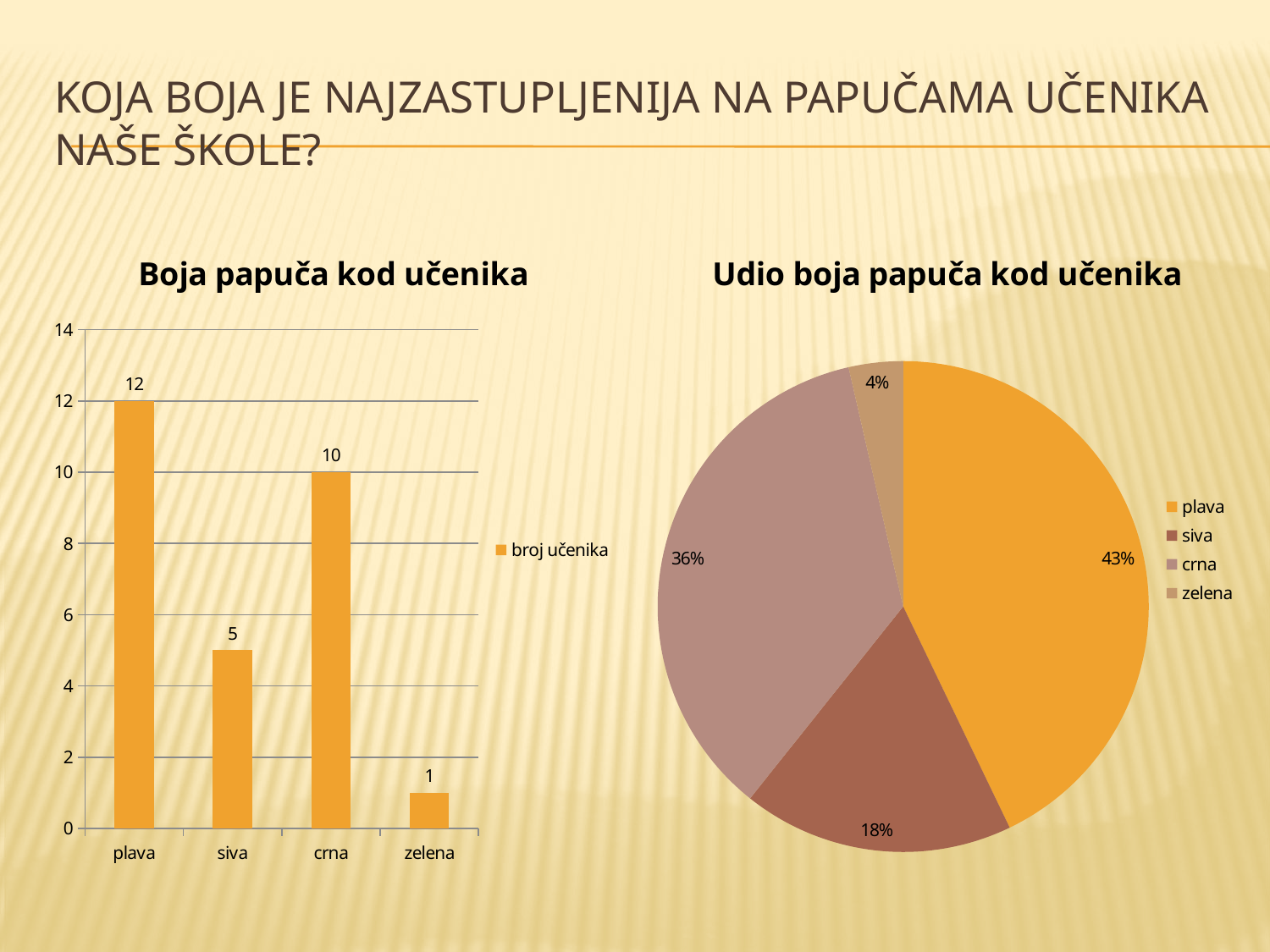
What kind of chart is the chart titled 'Boja papuča kod učenika'? bar chart In the chart titled 'Boja papuča kod učenika', what is the value for plava? 12 In the chart titled 'Boja papuča kod učenika', which is larger, the value for siva or the value for crna? crna In the chart titled 'Boja papuča kod učenika', how many categories are shown on the x axis? 4 In the chart titled 'Udio boja papuča kod učenika', what share does crna have? 36% What kind of chart is the chart titled 'Udio boja papuča kod učenika'? pie chart In the chart titled 'Boja papuča kod učenika', what is the difference between the values for plava and crna? 2 In the chart titled 'Boja papuča kod učenika', which category has the highest value? plava In the chart titled 'Boja papuča kod učenika', what is the value for siva? 5 In the chart titled 'Udio boja papuča kod učenika', what share does zelena have? 4% In the chart titled 'Udio boja papuča kod učenika', how many entries does the legend list? 4 In the chart titled 'Boja papuča kod učenika', which category has the lowest value? zelena